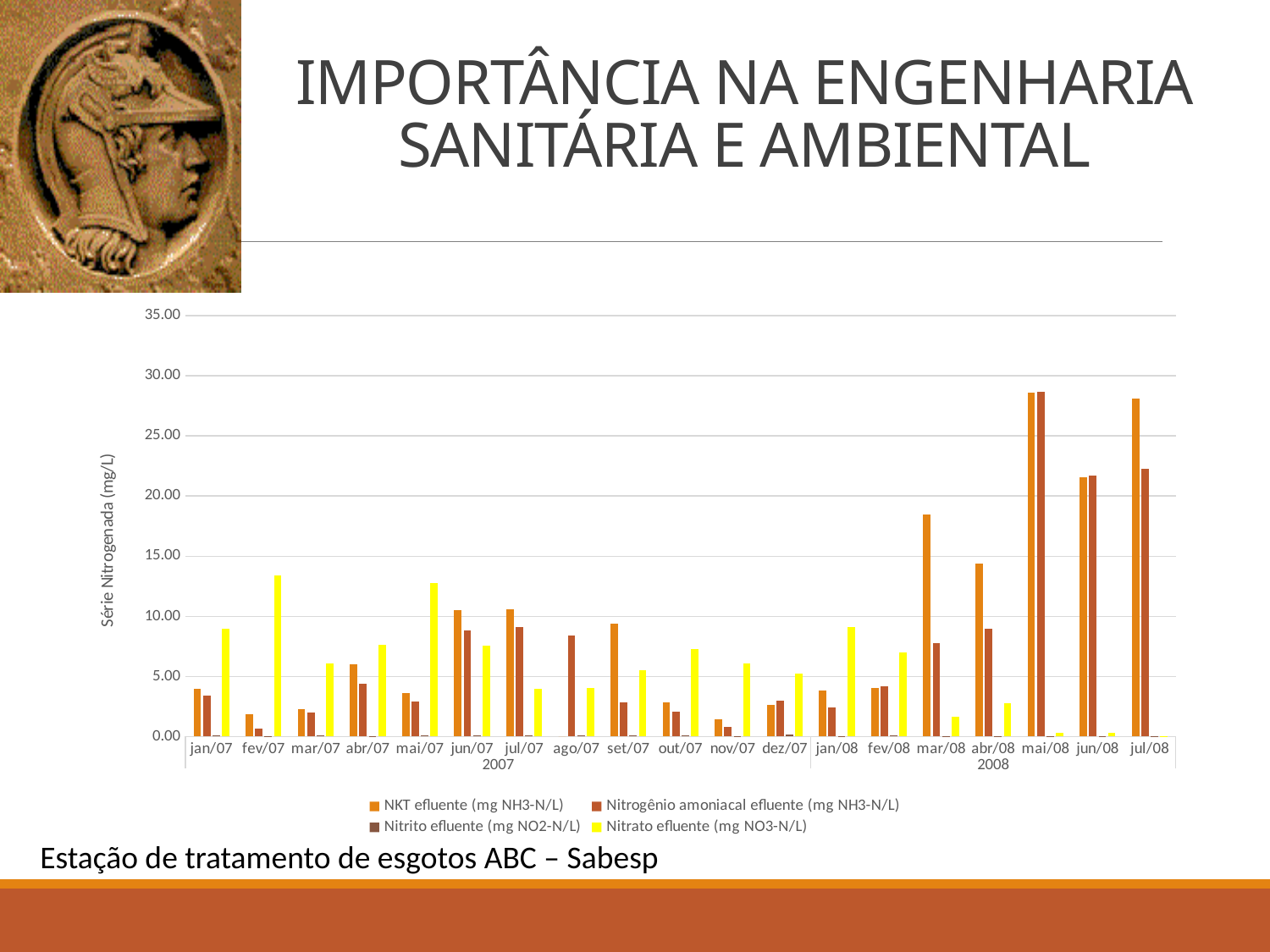
How many series does the chart legend list? 4 Is the value of NKT efluente for jan/07 greater or less than 5.00? less Is the value of Nitrogênio amoniacal efluente for mai/08 greater or less than 25.00? greater In which month is the Nitrogênio amoniacal efluente value highest? mai/08 What is the label of the vertical axis of the chart? Série Nitrogenada (mg/L) What kind of chart is shown on the slide? bar chart Which colour represents the series 'Nitrato efluente (mg NO3-N/L)' in the chart? yellow Is the value of Nitrato efluente for fev/07 greater or less than 10.00? greater Which is larger, the NKT efluente value for mar/08 or for abr/08? mar/08 Which is larger, the Nitrato efluente value for fev/07 or for jan/07? fev/07 How many months (categories) are plotted along the x axis of the chart? 19